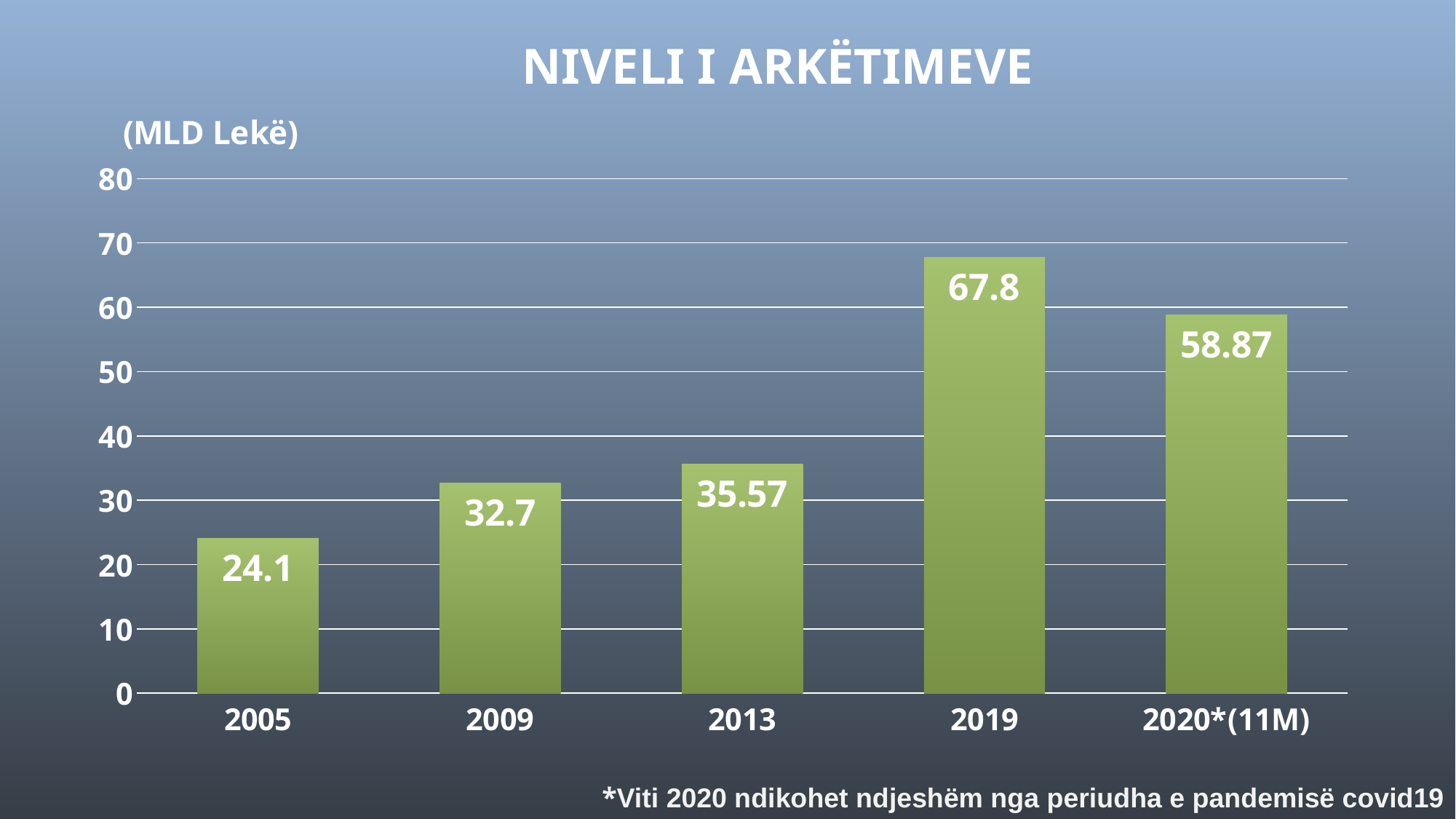
How many years are shown on the x axis? 5 What is the difference between the values for 2009 and 2005? 8.6 What is the title of the chart? NIVELI I ARKËTIMEVE What is the value for 2020*(11M)? 58.87 What is the difference between the values for 2019 and 2020*(11M)? 8.93 Which is larger, the value for 2013 or the value for 2009? 2013 What is the value for 2005? 24.1 Is the value for 2013 greater or less than 40? less Which year has the highest value? 2019 What kind of chart is shown? bar chart What is the value for 2019? 67.8 Which year has the lowest value? 2005